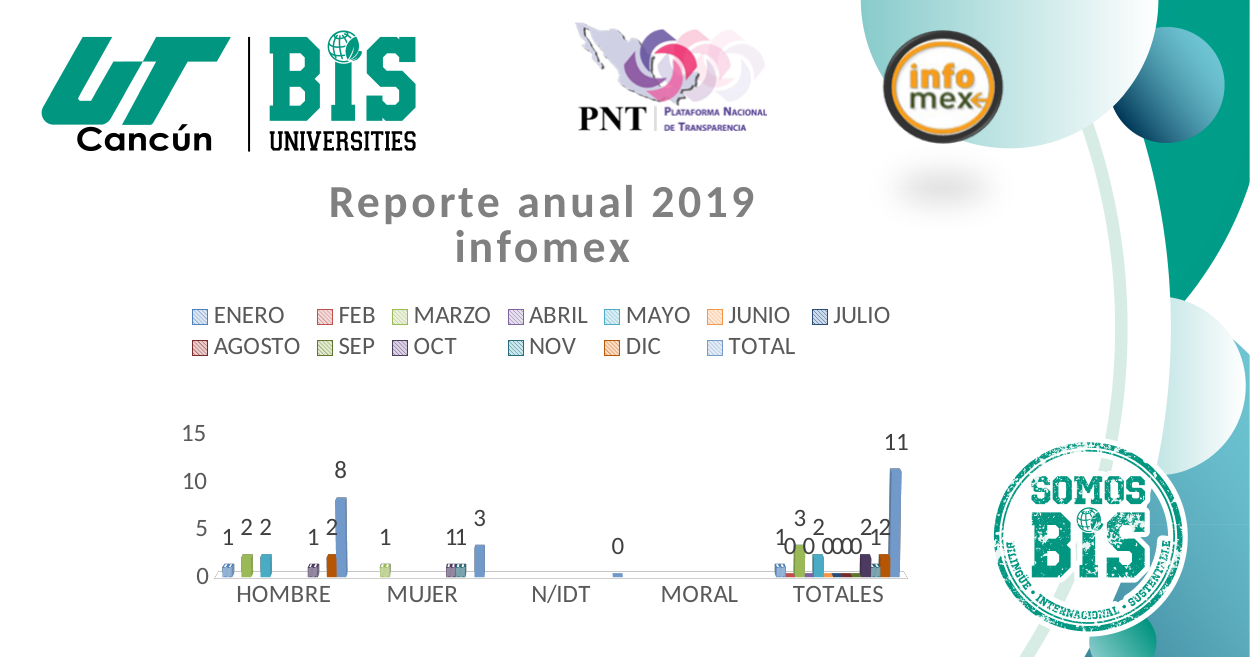
How many series does the chart legend list? 13 What is the highest tick value shown on the vertical axis? 15 What is the title of the chart? Reporte anual 2019 infomex Is the TOTAL value for TOTALES greater or less than 10? greater What is the difference between the TOTAL value for TOTALES and the TOTAL value for HOMBRE? 3 How many categories are shown along the x axis of the chart? 5 Which is larger, the TOTAL value for HOMBRE or the TOTAL value for MUJER? HOMBRE Which category has the highest value for the TOTAL series? TOTALES What is the value of the TOTAL series for MUJER? 3 What is the value of the TOTAL series for HOMBRE? 8 What is the value of the TOTAL series for TOTALES? 11 What kind of chart is shown on the slide? bar chart